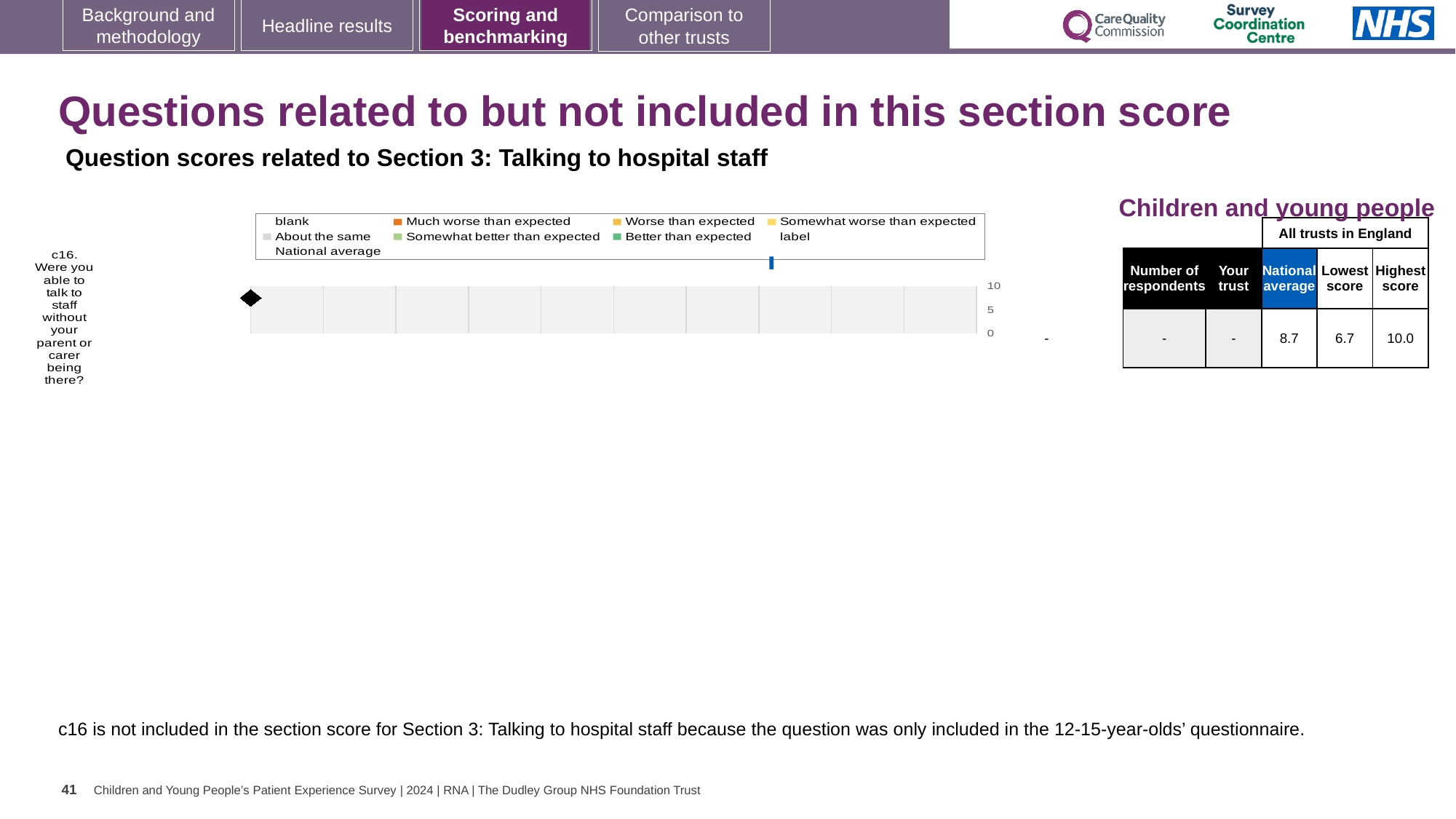
In the table next to the chart, what is the Highest score across all trusts in England for c16? 10.0 How many entries does the chart's legend list? 9 What kind of chart is shown on the slide? bar chart In the table next to the chart, what is the difference between the Highest score and the Lowest score for c16? 3.3 In the table next to the chart, what is the Lowest score across all trusts in England for c16? 6.7 In the table next to the chart, is the National average for c16 greater or less than 5? greater Which question number is the single category on the chart? c16 What is the highest value shown on the chart's numeric axis? 10 In the table next to the chart, what is the National average score for c16? 8.7 How many question categories are listed on the chart's vertical axis? 1 In the table next to the chart, what is shown for Your trust for c16? -